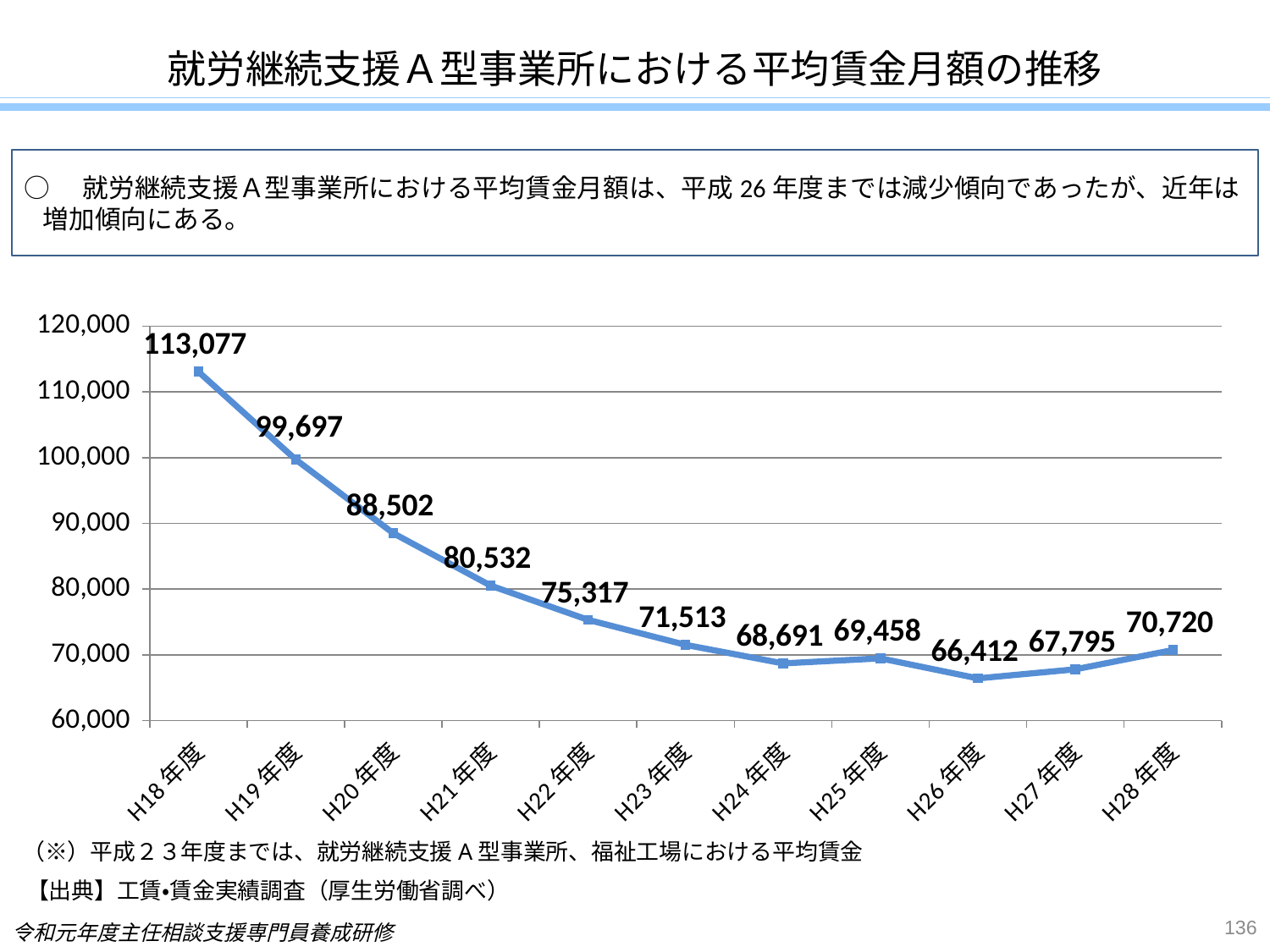
What is the value plotted for H28年度? 70,720 What kind of chart is shown on the slide? line chart Which fiscal year has the highest value on the chart? H18年度 What is the value plotted for H26年度? 66,412 Do the values rise or fall from H18年度 to H24年度? fall What is the difference between the values for H28年度 and H27年度? 2,925 Which is larger, the value for H24年度 or the value for H25年度? H25年度 Is the value for H22年度 greater or less than 80,000? less What is the difference between the values for H18年度 and H19年度? 13,380 How many fiscal years are plotted on the chart? 11 What is the average monthly wage value for H18年度? 113,077 Which fiscal year has the lowest value on the chart? H26年度